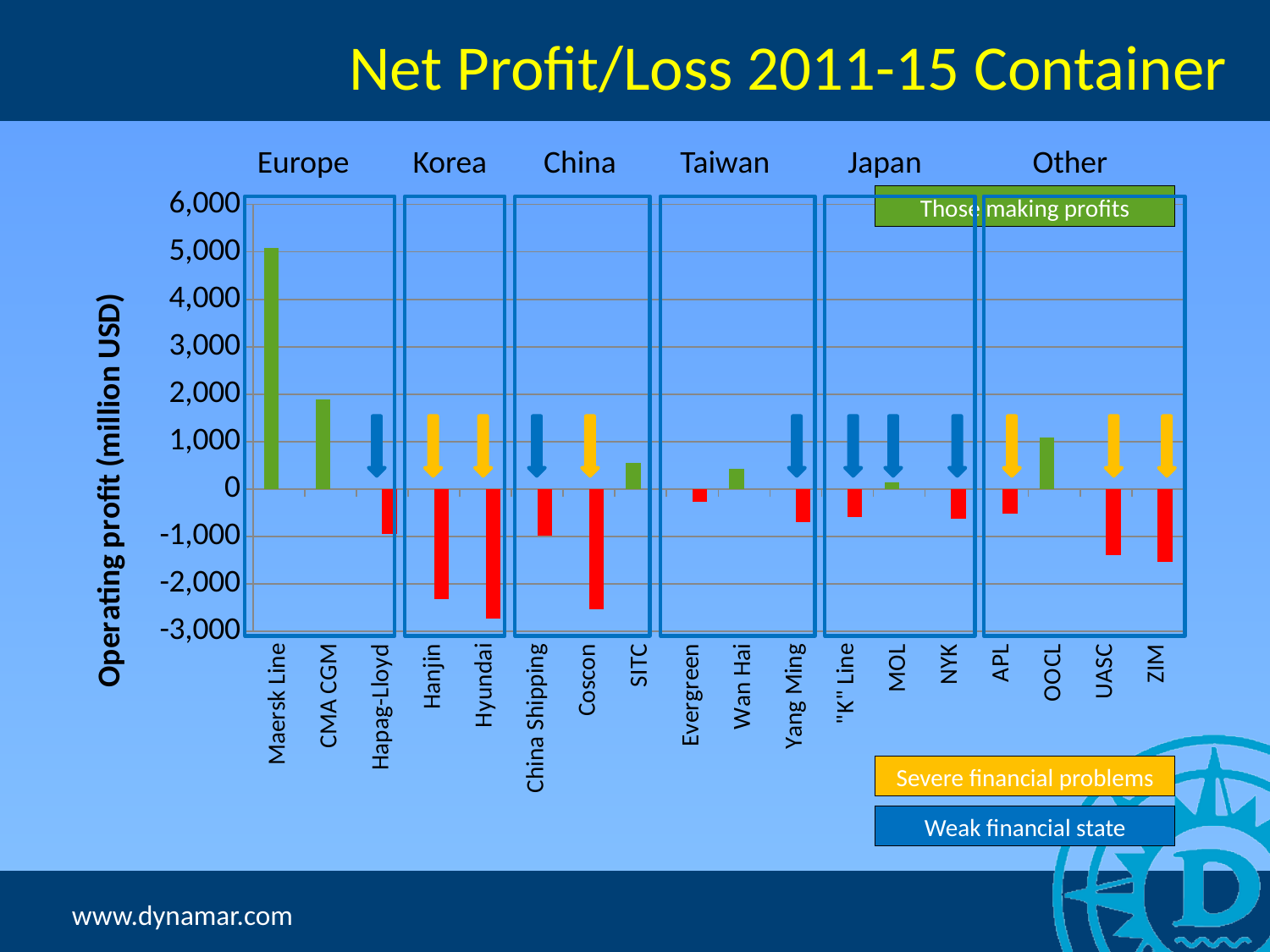
Which is larger, the value for Hapag-Lloyd or the value for Hanjin? Hapag-Lloyd Is the value for Maersk Line greater or less than 4,000? greater What is the title of the vertical axis? Operating profit (million USD) Is the value for Hanjin greater or less than -2,000? less Which is larger, the value for Maersk Line or the value for CMA CGM? Maersk Line Which colour of arrow marks companies with severe financial problems? yellow What kind of chart is shown on the slide? bar chart How many companies are plotted on the chart? 18 Is the value for CMA CGM greater or less than 1,000? greater Which company has the highest operating profit on the chart? Maersk Line